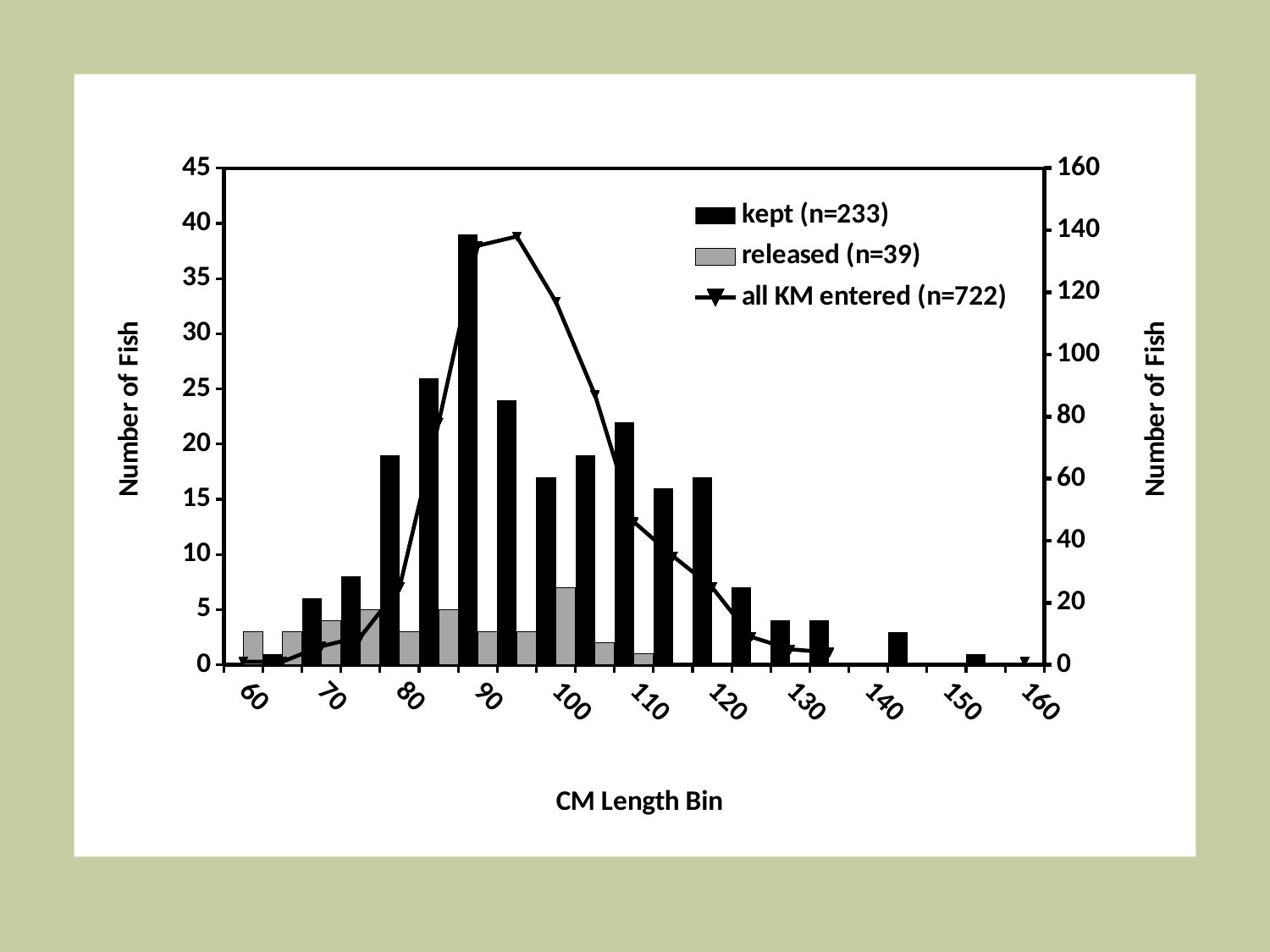
Is the 'all KM entered' line value at the 110 cm bin greater or less than 60 on the right axis? less What kind of chart is shown on the slide? A combination bar and line chart What is the highest tick value shown on the right-hand axis? 160 Does the 'all KM entered' line rise or fall between the 100 and 130 cm length bins? fall Is the tallest 'released' bar greater or less than 10 on the left axis? less Which series has the taller bar around the 90 cm length bin, 'kept' or 'released'? kept What is the title of the x axis? CM Length Bin Is the peak of the 'all KM entered' line greater or less than 120 on the right axis? greater What is the sample size (n) given in the legend for the 'kept' series? 233 How many series does the legend list? 3